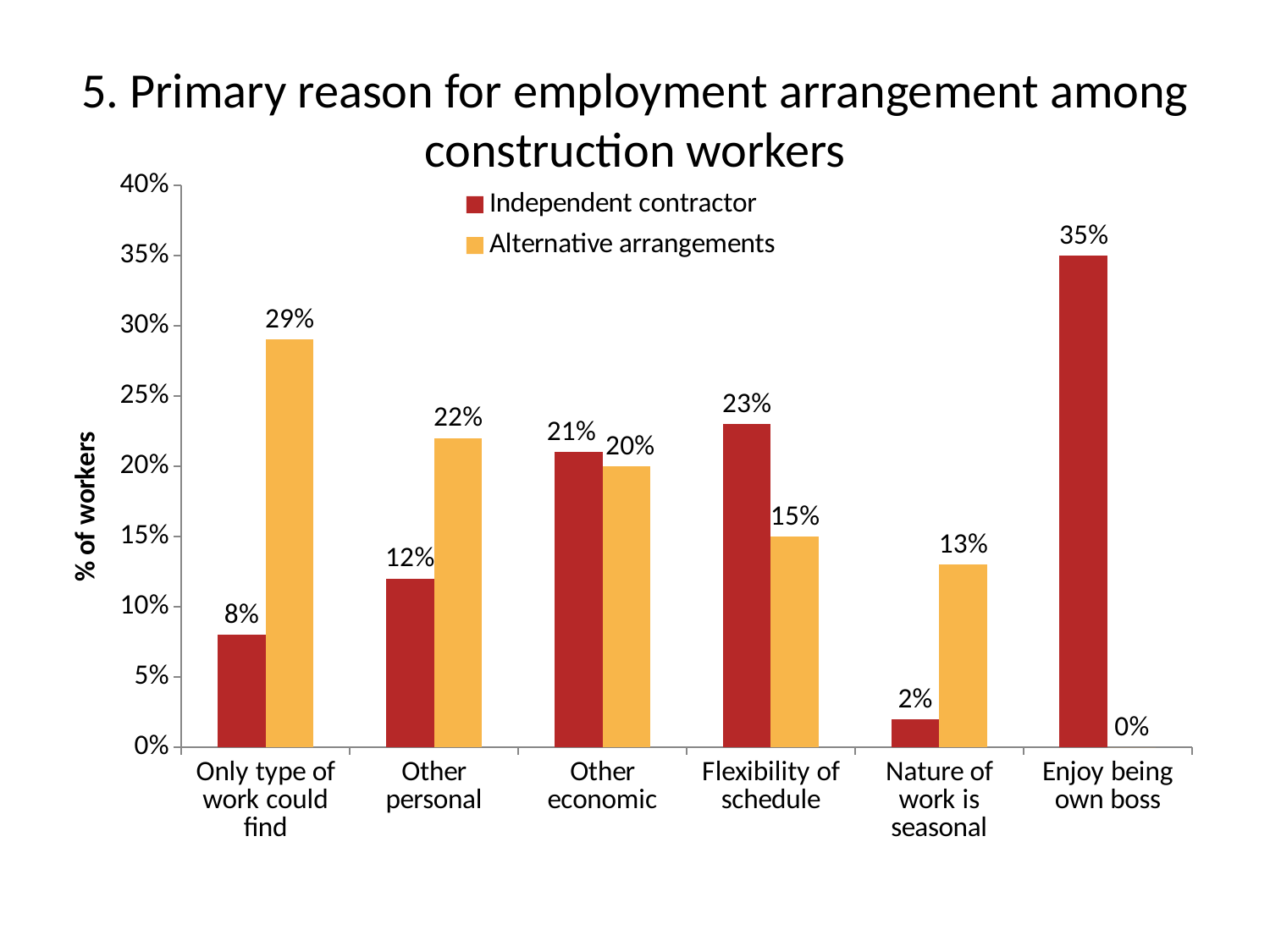
What is the value for 'Alternative arrangements' in the 'Only type of work could find' category? 29% Is the 'Alternative arrangements' value for 'Other personal' greater or less than 20%? greater Which category has the highest value for the 'Independent contractor' series? Enjoy being own boss Which category has the lowest value for the 'Alternative arrangements' series? Enjoy being own boss What is the value for 'Independent contractor' in the 'Nature of work is seasonal' category? 2% How many series does the legend list? 2 What is the label of the y axis? % of workers How many categories are shown on the x axis? 6 What percentage of independent contractors cite 'Enjoy being own boss' as their primary reason? 35% What kind of chart is shown on the slide? Bar chart What is the difference between the 'Alternative arrangements' and 'Independent contractor' values for 'Only type of work could find'? 21% In the 'Flexibility of schedule' category, which series has the larger value? Independent contractor